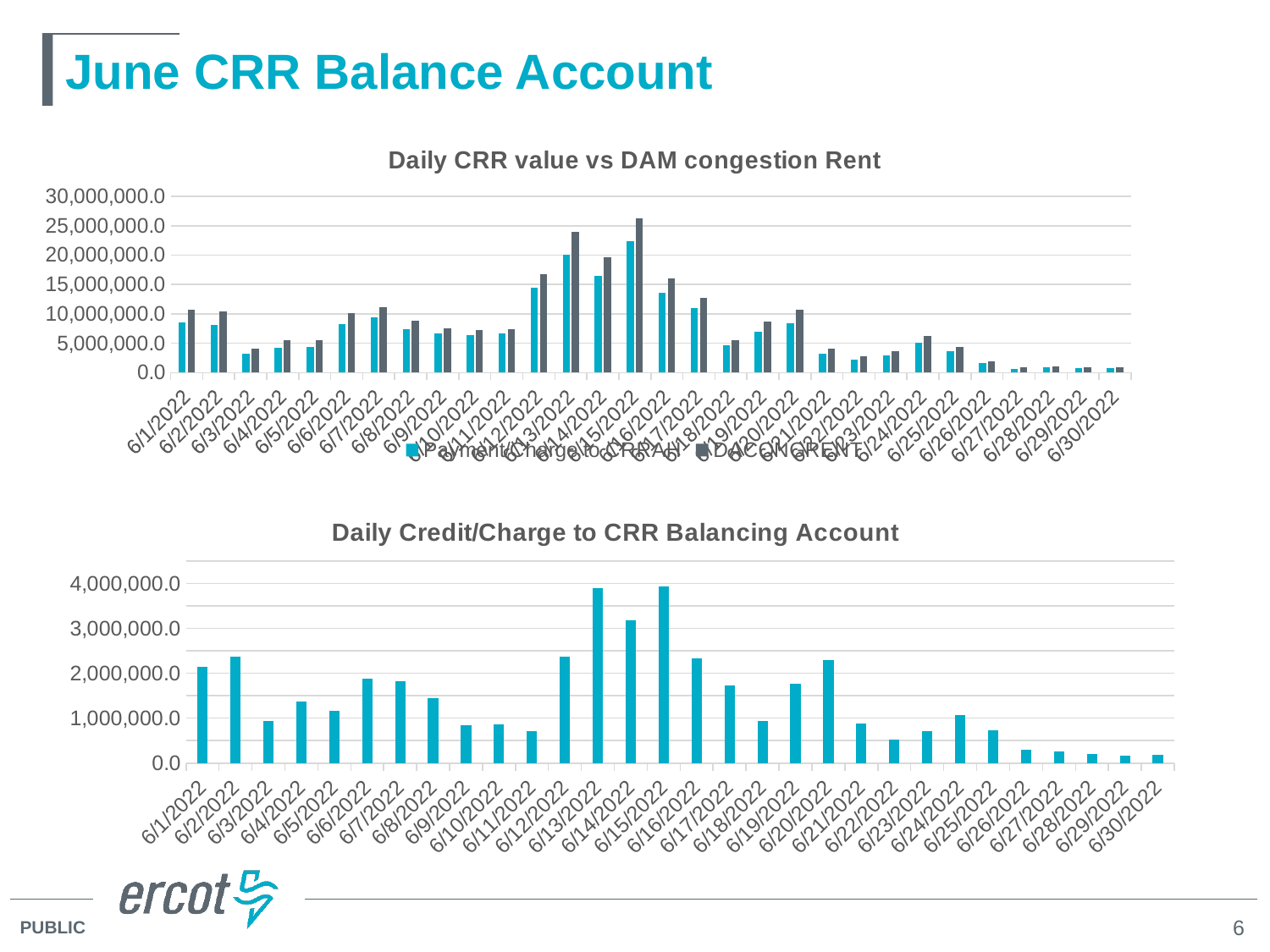
In the 'Daily Credit/Charge to CRR Balancing Account' chart, which is larger, the value for 6/13/2022 or the value for 6/14/2022? 6/13/2022 In the 'Daily Credit/Charge to CRR Balancing Account' chart, is the value for 6/14/2022 greater or less than 3,000,000.0? greater How many series does the legend of the 'Daily CRR value vs DAM congestion Rent' chart list? 2 In the 'Daily CRR value vs DAM congestion Rent' chart, is the dark grey bar for 6/15/2022 greater or less than 25,000,000.0? greater How many dates are shown on the x axis of the 'Daily Credit/Charge to CRR Balancing Account' chart? 30 In the 'Daily Credit/Charge to CRR Balancing Account' chart, is the value for 6/2/2022 greater or less than 2,000,000.0? greater In the 'Daily Credit/Charge to CRR Balancing Account' chart, do the values rise or fall from 6/25/2022 to 6/30/2022? fall In the 'Daily CRR value vs DAM congestion Rent' chart, on which date is the dark grey series highest? 6/15/2022 In the 'Daily CRR value vs DAM congestion Rent' chart, do the teal bars rise or fall from 6/12/2022 to 6/15/2022? rise What kind of chart is the 'Daily Credit/Charge to CRR Balancing Account' chart? bar chart